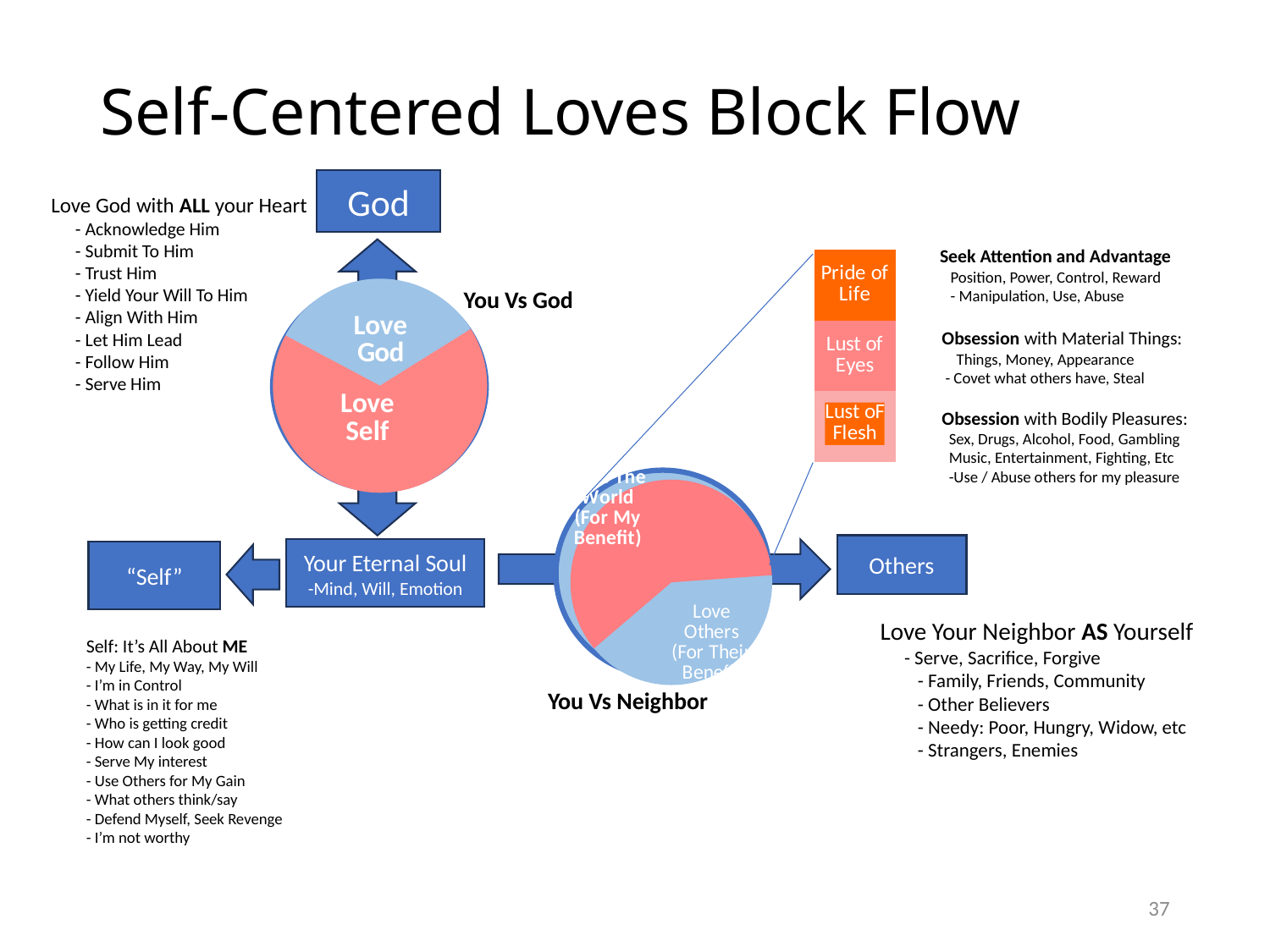
In the "You Vs God" pie chart, how many slices are there? 2 What kind of chart is the "You Vs Neighbor" chart in the middle of the slide? Pie chart In the "You Vs Neighbor" pie chart, which slice is the largest? Love The World (For My Benefit) What kind of chart is the "You Vs God" chart on the left of the slide? Pie chart In the "You Vs God" pie chart, which slice is larger, "Love God" or "Love Self"? Love Self In the "You Vs Neighbor" pie chart, how many slices are there? 2 In the "You Vs God" pie chart, which slice is the smallest? Love God In the "You Vs God" pie chart, what are the labels of the two slices? Love God and Love Self In the "You Vs Neighbor" pie chart, which slice is larger, "Love The World (For My Benefit)" or "Love Others (For Their Benefit)"? Love The World (For My Benefit) In the "You Vs God" pie chart, what colour is the "Love Self" slice? Red (pink)